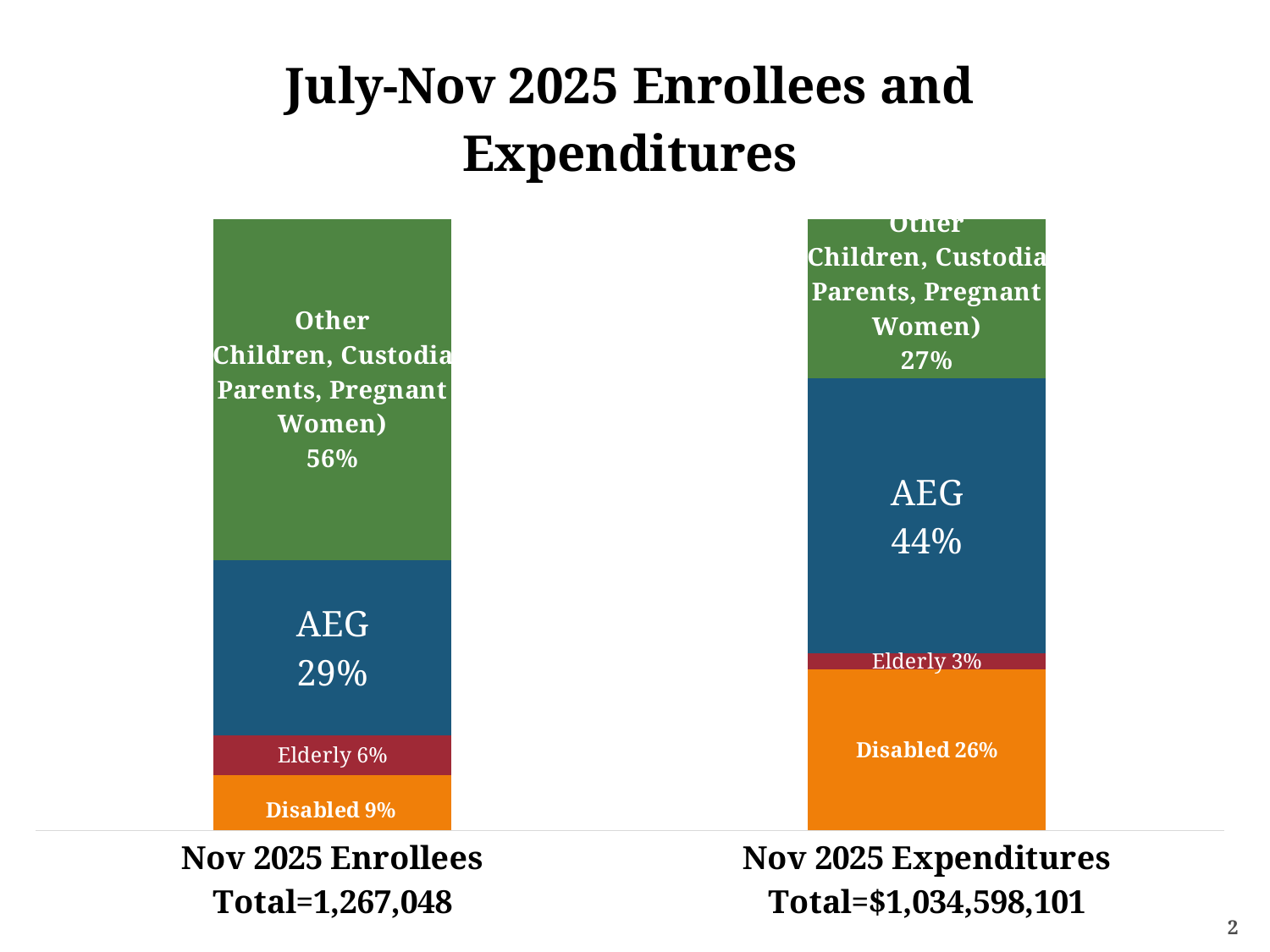
How many segments make up each stacked bar? 4 Is the AEG share larger for Nov 2025 Enrollees or Nov 2025 Expenditures? Nov 2025 Expenditures What kind of chart is shown on the slide? Stacked bar chart What share of Nov 2025 Enrollees is AEG? 29% How many bars are shown in the chart? 2 Which group has the smallest share of Nov 2025 Expenditures? Elderly What is the difference between the Disabled share of Nov 2025 Expenditures and the Disabled share of Nov 2025 Enrollees? 17 percentage points What share of Nov 2025 Expenditures is Disabled? 26% What is the total for Nov 2025 Expenditures shown under the chart? $1,034,598,101 What share of Nov 2025 Expenditures is AEG? 44% Which group has the largest share of Nov 2025 Enrollees? Other (Children, Custodial Parents, Pregnant Women) What share of Nov 2025 Enrollees is Elderly? 6%